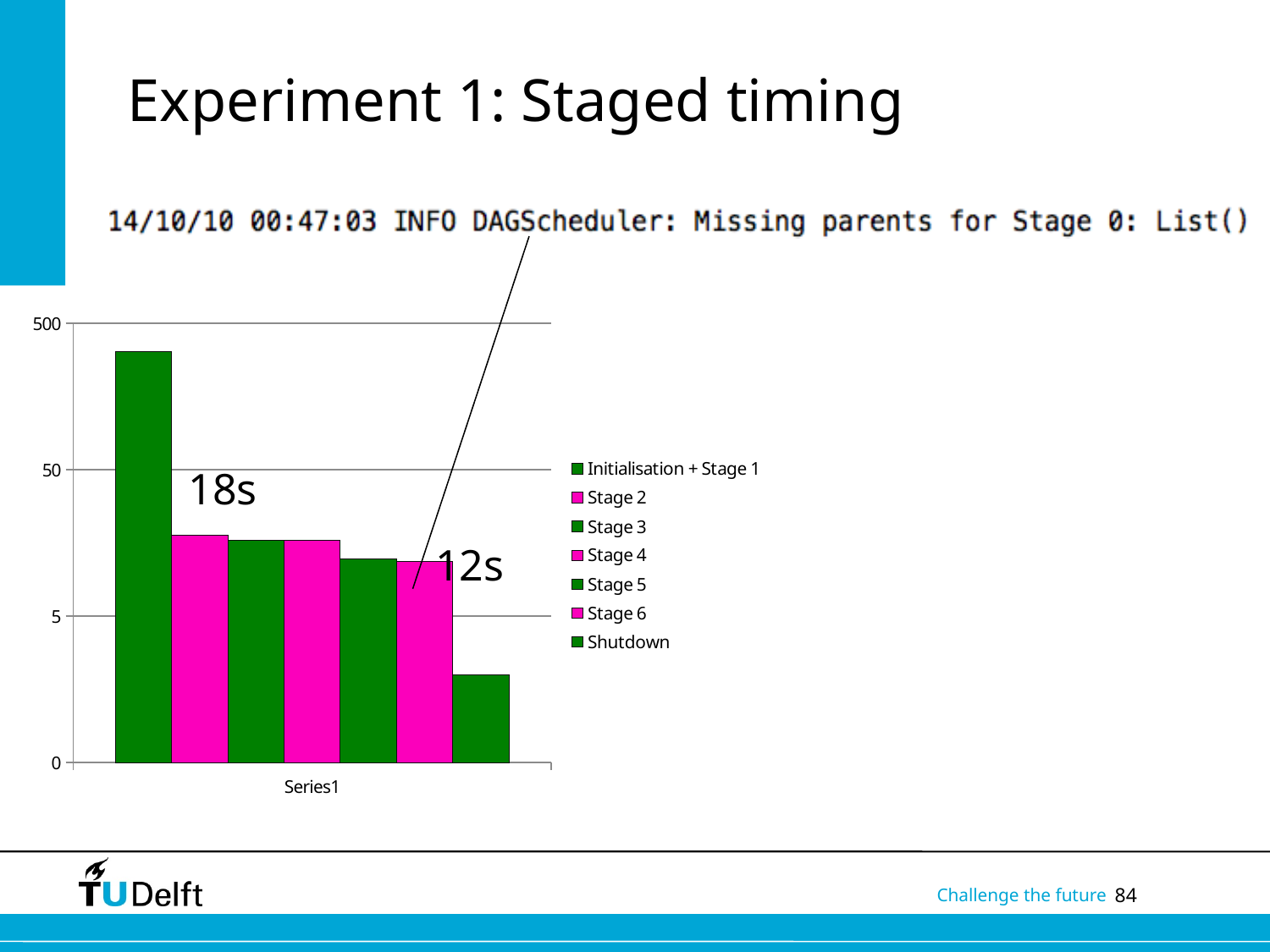
Which stage has the highest bar in the chart? Initialisation + Stage 1 Do the bar heights generally rise or fall from left to right across the chart? fall Is the value for Shutdown greater or less than 5? less How many bars are plotted in the chart? 7 Which stage has the lowest bar in the chart? Shutdown Which is larger, the value for Shutdown or the value for Stage 6? Stage 6 How many entries does the chart legend list? 7 What kind of chart is shown on the slide? bar chart Which is larger, the value for Stage 2 or the value for Stage 5? Stage 2 Is the value for Initialisation + Stage 1 greater or less than 50? greater Is the value for Stage 2 greater or less than 50? less What label is shown under the x axis of the chart? Series1